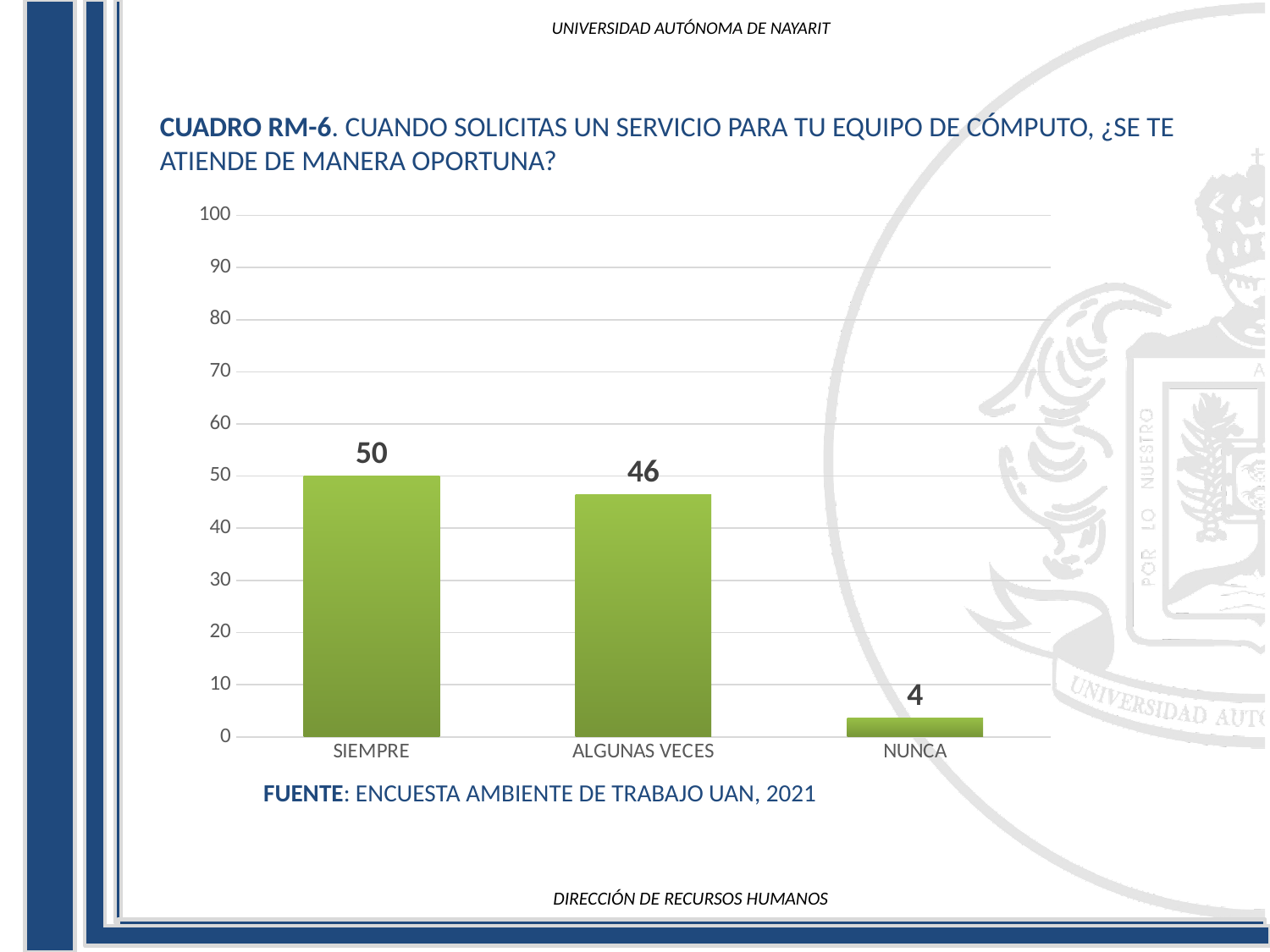
Is the value for ALGUNAS VECES greater or less than 40? greater What is the difference between the values for ALGUNAS VECES and NUNCA? 42 Which category has the highest value? SIEMPRE What source is cited below the chart? ENCUESTA AMBIENTE DE TRABAJO UAN, 2021 What kind of chart is shown on the slide? bar chart Which category has the lowest value? NUNCA Which is larger, the value for SIEMPRE or the value for NUNCA? SIEMPRE What is the value for NUNCA? 4 What is the difference between the values for SIEMPRE and ALGUNAS VECES? 4 What is the value for SIEMPRE? 50 What is the value for ALGUNAS VECES? 46 How many categories are shown on the x axis? 3